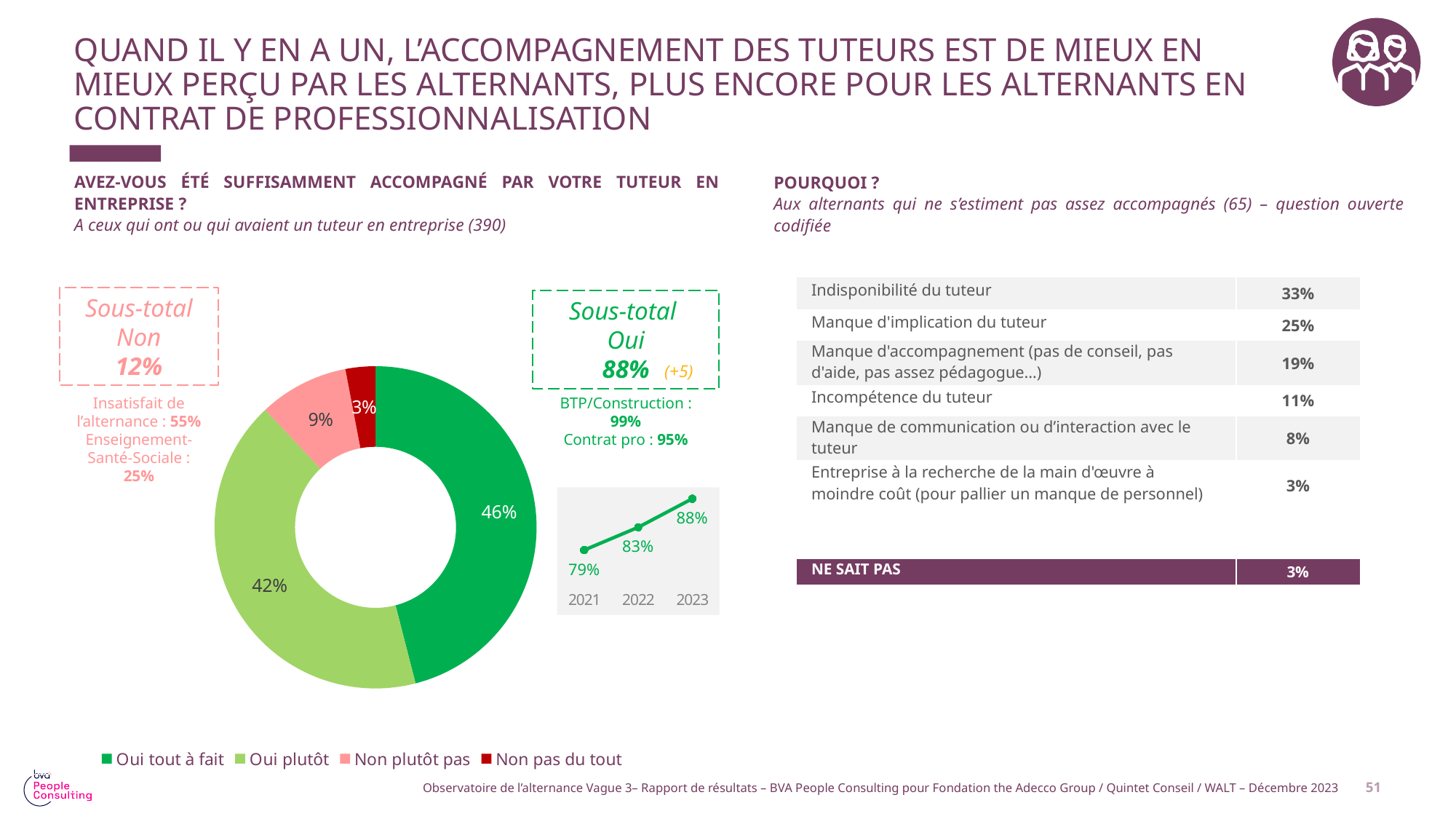
In the small line chart, do the values rise or fall from 2021 to 2023? Rise In the donut chart, what is the difference between the "Oui tout à fait" and "Oui plutôt" shares? 4 percentage points What kind of chart is the large chart on the left of the slide? Donut (pie) chart How many categories does the legend of the donut chart list? 4 In the donut chart, which is larger: "Non plutôt pas" or "Non pas du tout"? Non plutôt pas In the donut chart, which category has the smallest slice? Non pas du tout In the donut chart, what share of respondents answered "Non plutôt pas"? 9% In the small line chart, what is the difference between the 2023 and 2021 values? 9 percentage points In the donut chart, which category has the largest slice? Oui tout à fait In the small line chart showing the evolution of the "Sous-total Oui", what is the value for 2022? 83% In the donut chart, what share of respondents answered "Oui tout à fait"? 46% In the small line chart showing the evolution of the "Sous-total Oui", what is the value for 2021? 79%